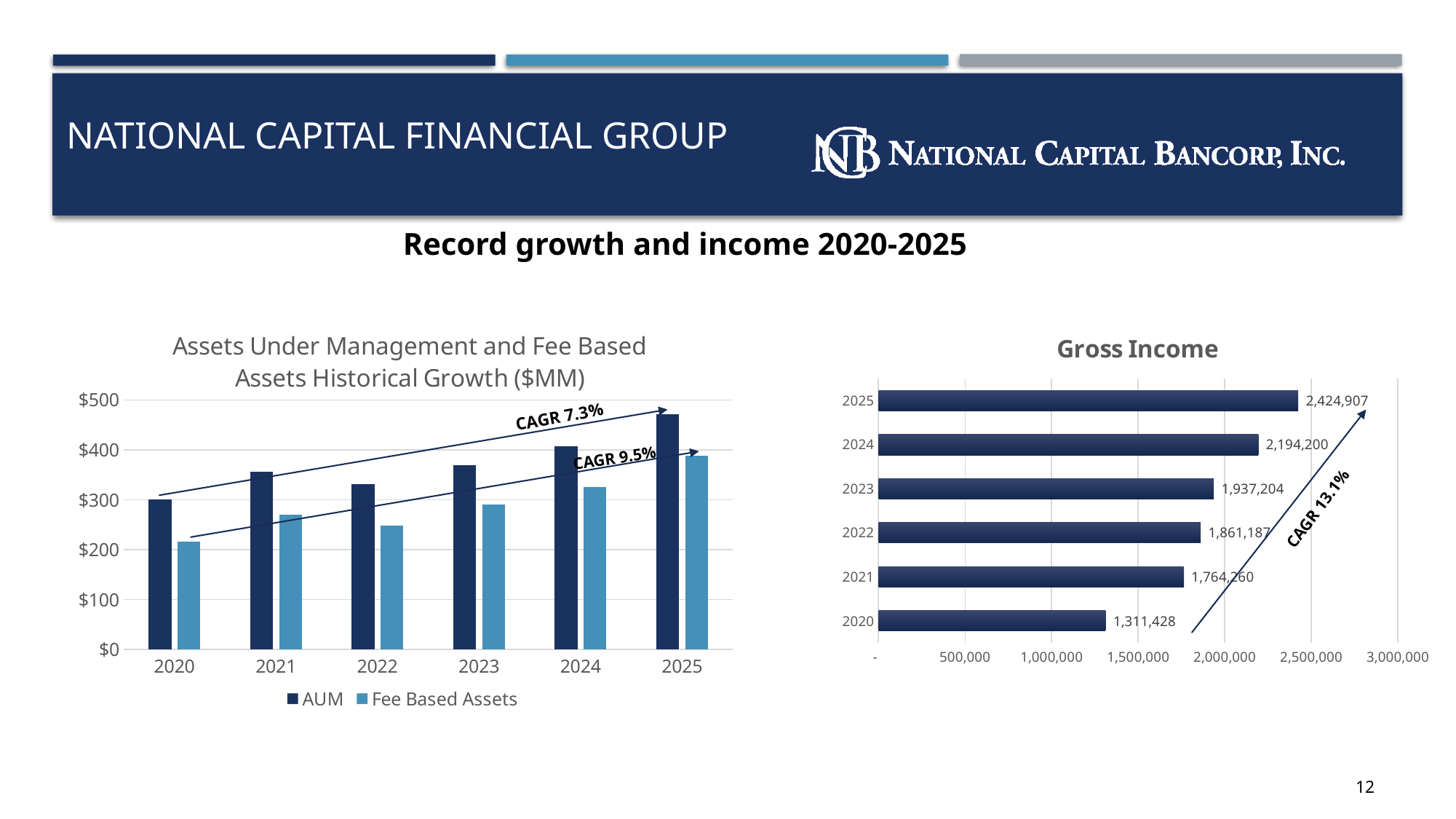
In the Assets Under Management and Fee Based Assets chart, how many series does the legend list? 2 In the Gross Income chart, what is the value for 2025? 2,424,907 In the Assets Under Management and Fee Based Assets chart, is the Fee Based Assets value for 2020 greater or less than $300? less In the Gross Income chart, what is the difference between the 2024 and 2023 values? 256,996 In the Gross Income chart, what is the value for 2020? 1,311,428 In the Gross Income chart, what is the value for 2022? 1,861,187 In the Assets Under Management and Fee Based Assets chart, is the AUM value for 2025 greater or less than $400? greater In the Gross Income chart, how many years are shown? 6 In the Gross Income chart, what is the difference between the 2025 and 2020 values? 1,113,479 In the Gross Income chart, which year has the highest gross income? 2025 What type of chart is the Gross Income chart? Bar chart In the Gross Income chart, which year has the lowest gross income? 2020